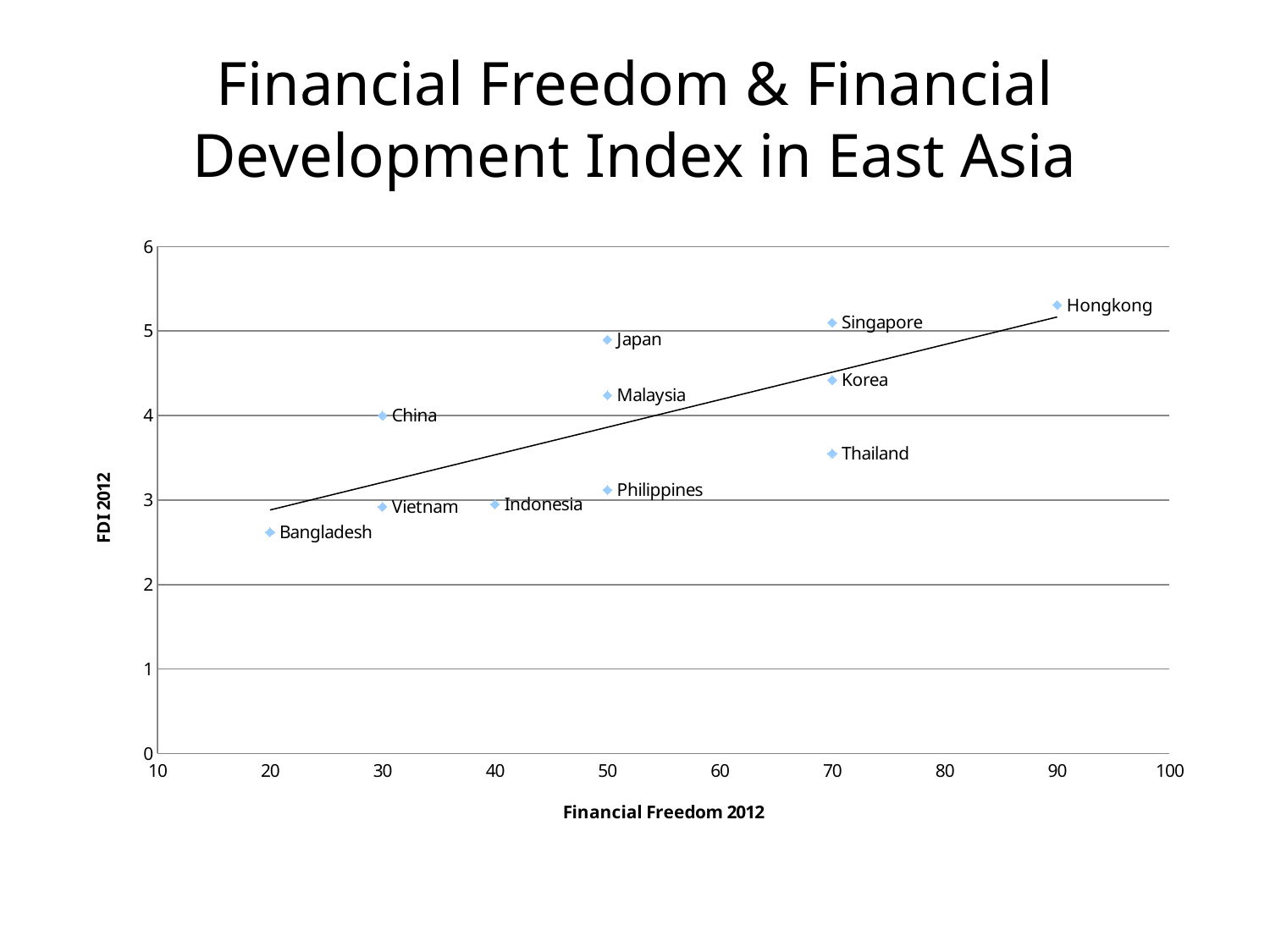
Does the trend line show FDI 2012 rising or falling as Financial Freedom 2012 increases? rising Which has a higher FDI 2012 value, Singapore or Korea? Singapore Is the FDI 2012 value for Singapore greater or less than 5? greater What is the Financial Freedom 2012 value for Bangladesh? 20 Is the FDI 2012 value for Thailand greater or less than 4? less Which country has the highest FDI 2012 value? Hongkong What is the Financial Freedom 2012 value for Indonesia? 40 Is the FDI 2012 value for Japan greater or less than 4? greater Which country has the lowest FDI 2012 value? Bangladesh What is the Financial Freedom 2012 value for Hongkong? 90 What kind of chart is shown on the slide? scatter chart How many countries are plotted on the chart? 11